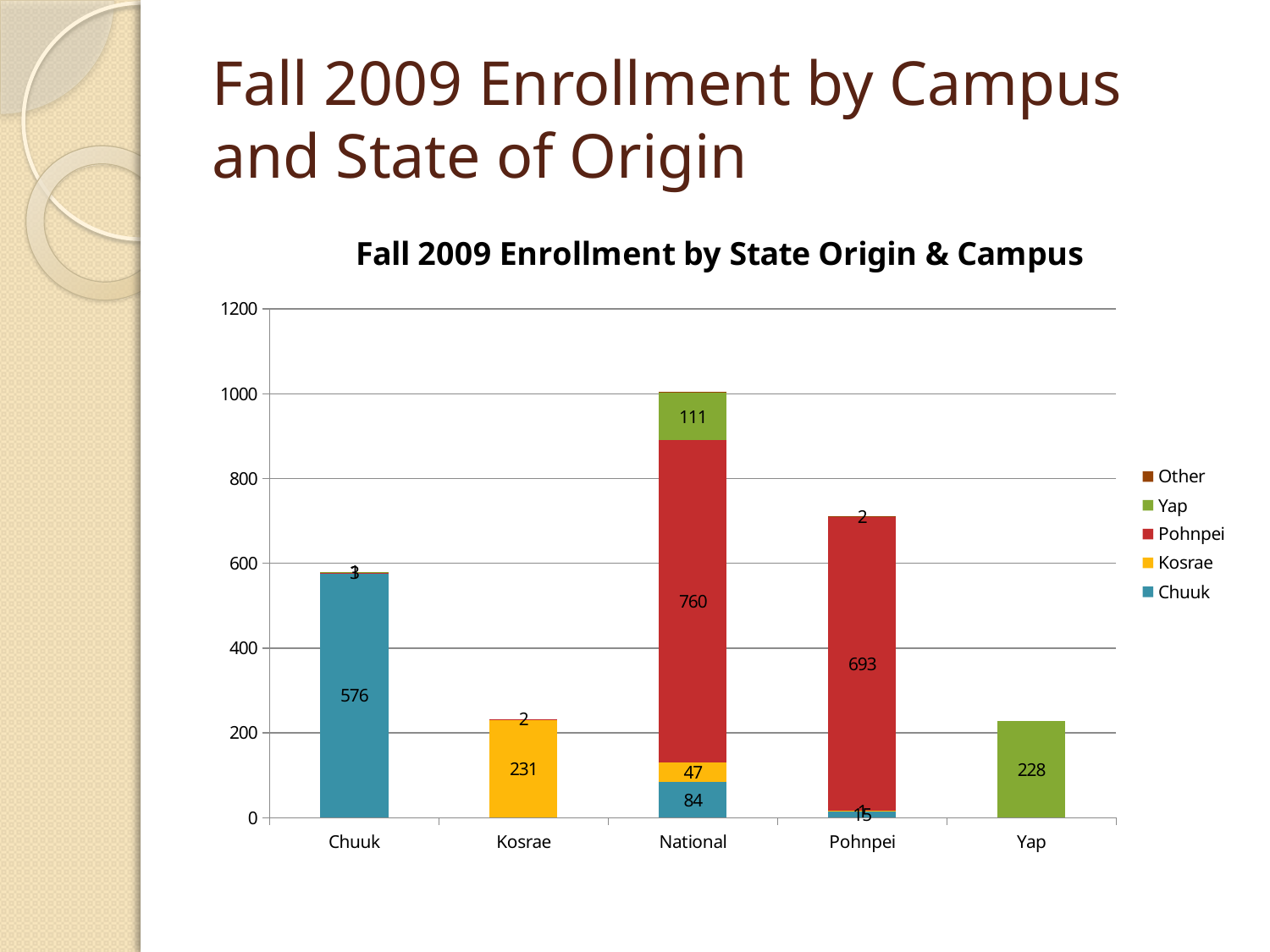
What kind of chart is shown on the slide? Stacked bar chart What is the difference between Pohnpei-origin enrollment at the National campus and at the Pohnpei campus? 67 Which campus has the highest total enrollment? National How many campuses are shown on the x axis? 5 How many Kosrae-origin students are enrolled at the Kosrae campus? 231 How many Pohnpei-origin students are enrolled at the Pohnpei campus? 693 How many Pohnpei-origin students are enrolled at the National campus? 760 How many Yap-origin students are enrolled at the National campus? 111 Is the total enrollment at the Pohnpei campus greater or less than 600? greater How many Chuuk-origin students are enrolled at the Chuuk campus? 576 How many Yap-origin students are enrolled at the Yap campus? 228 How many series does the legend list? 5